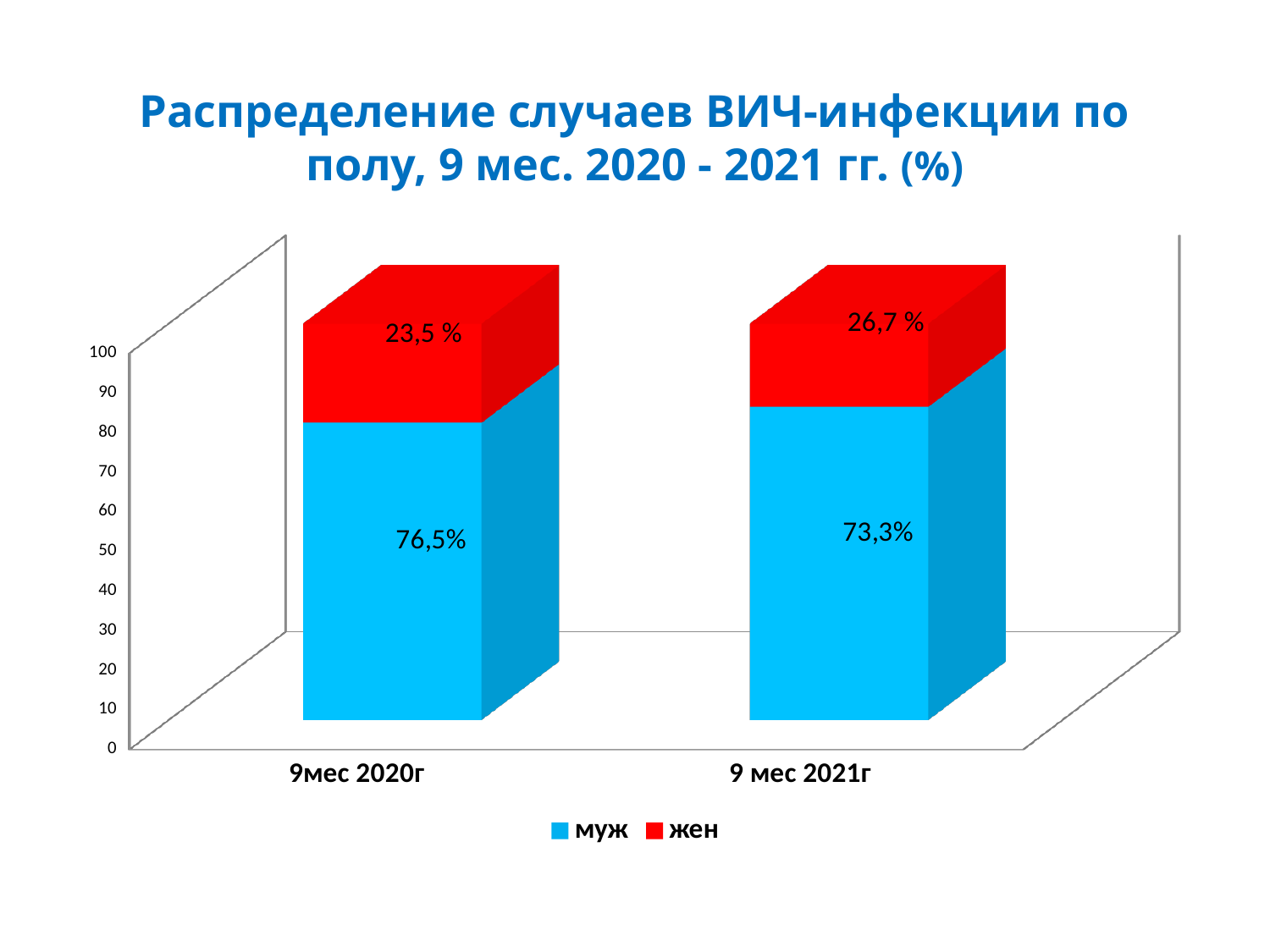
What is the value for жен in 9мес 2020г? 23,5 % What is the value for муж in 9мес 2020г? 76,5% What is the value for жен in 9 мес 2021г? 26,7 % What is the difference between the муж values for 9мес 2020г and 9 мес 2021г? 3,2% How many categories are shown on the x axis? 2 Which colour represents the series жен in the chart? Red What kind of chart is shown on the slide? Stacked bar chart How many series does the legend list? 2 What is the value for муж in 9 мес 2021г? 73,3%